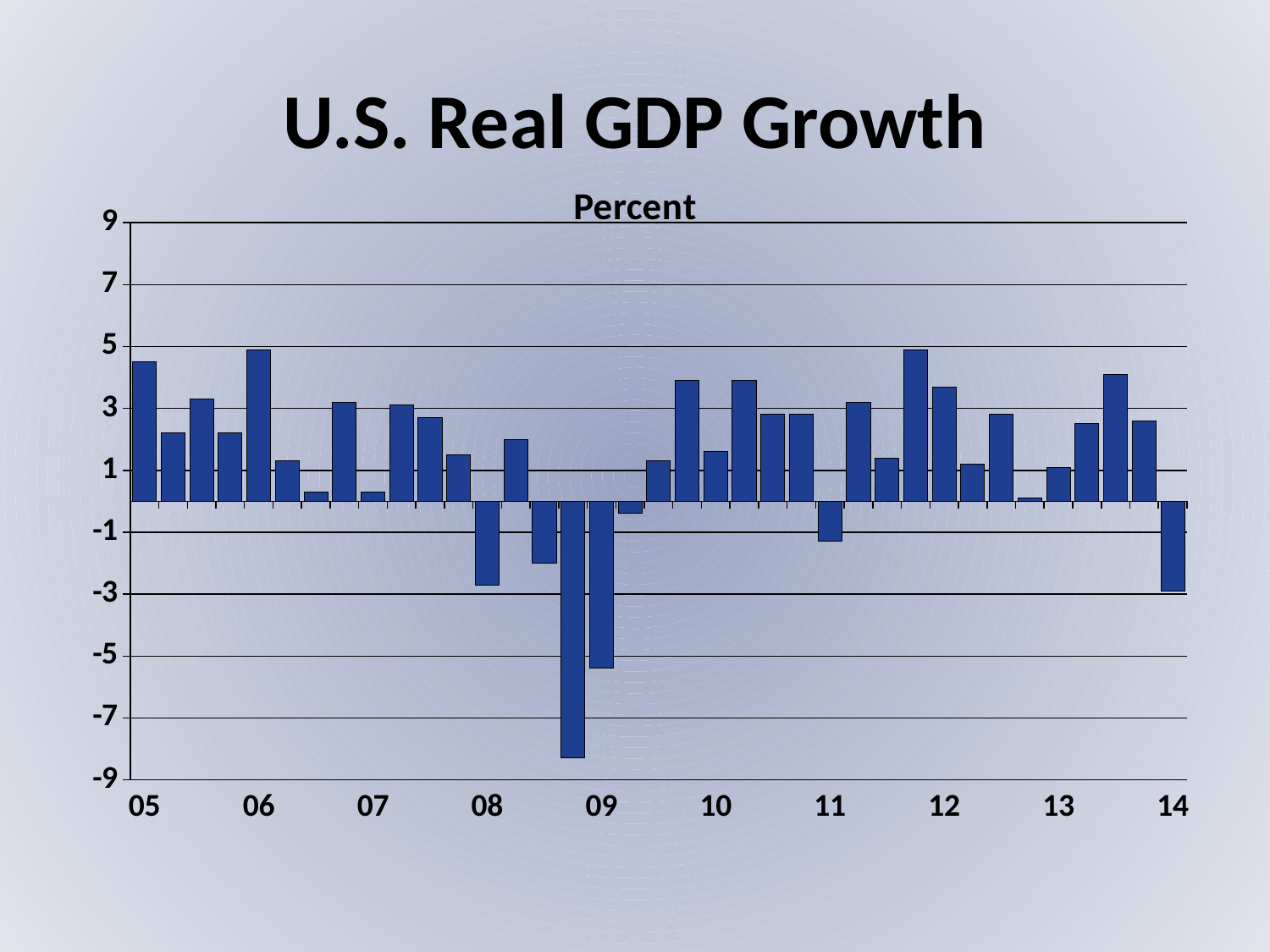
What is the highest value shown on the vertical axis? 9 Is the value of the bar directly above the 09 label greater or less than -3? less What kind of chart is shown on the slide? bar chart Is the value of the first bar for 06 greater or less than 3? greater What is the title of the chart? U.S. Real GDP Growth Which is larger, the first bar for 12 or the first bar for 13? the first bar for 12 What unit label is shown above the vertical axis? Percent Is the value of the bar at 14 greater or less than -1? less Which is larger, the first bar for 05 or the bar at 14? the first bar for 05 How many year labels appear along the x axis? 10